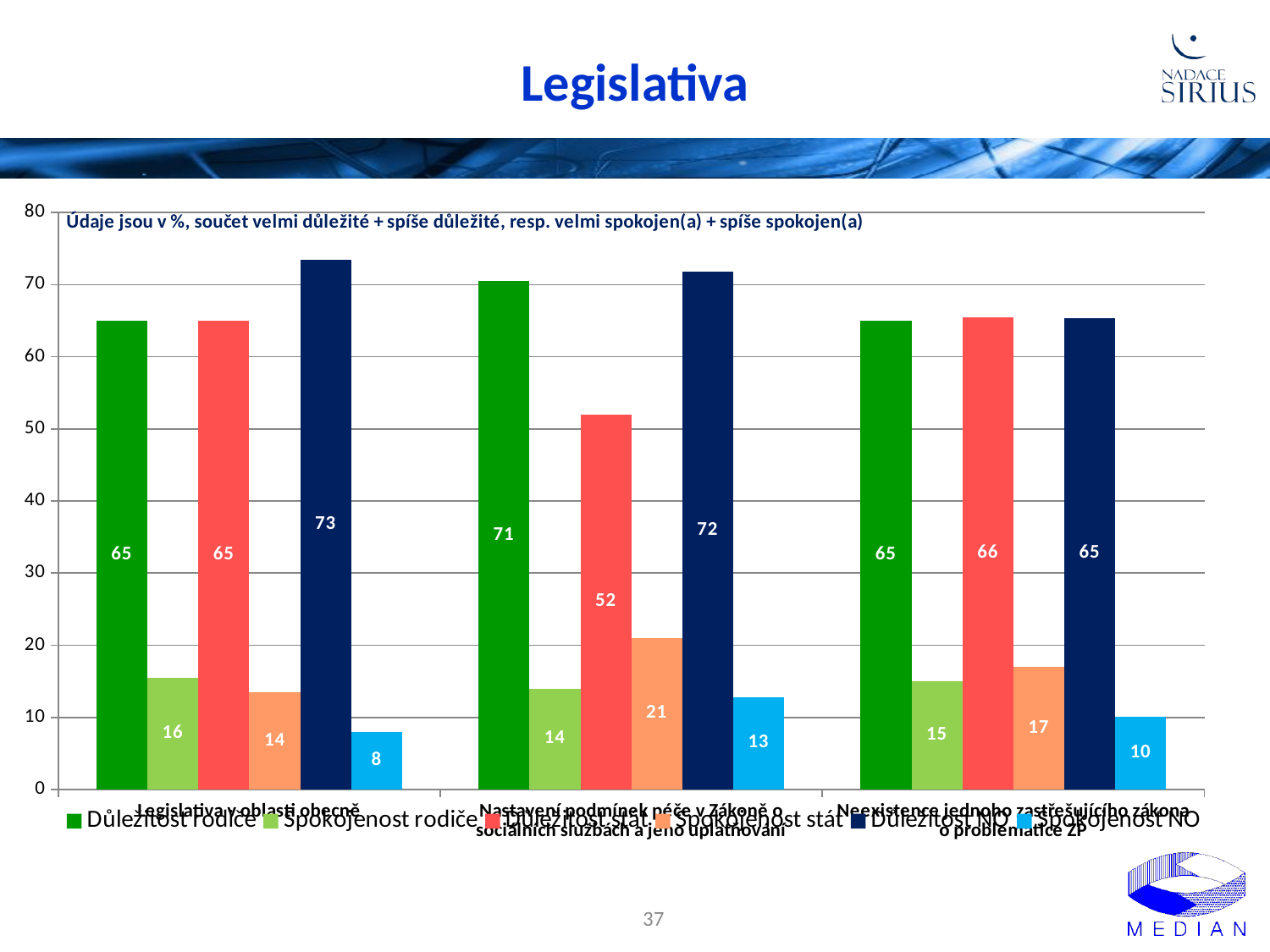
How many categories are shown on the x axis? 3 What is the title of the slide? Legislativa Which is larger in the first category, Legislativa v oblasti obecně: Spokojenost rodiče or Spokojenost stát? Spokojenost rodiče Is the value of Důležitost rodiče in the second category, Nastavení podmínek péče v Zákoně o sociálních službách a jeho uplatňování, greater or less than 60? greater What type of chart is shown on the slide? bar chart What is the value of Spokojenost NO for the category Neexistence jednoho zastřešujícího zákona o problematice ZP? 10 What is the difference between Důležitost stát and Spokojenost stát in the second category, Nastavení podmínek péče v Zákoně o sociálních službách a jeho uplatňování? 31 Which series has the highest value in the second category, Nastavení podmínek péče v Zákoně o sociálních službách a jeho uplatňování? Důležitost NO What is the value of Důležitost NO for the first category, Legislativa v oblasti obecně? 73 What is the value of Spokojenost stát for the category Nastavení podmínek péče v Zákoně o sociálních službách a jeho uplatňování? 21 How many series does the legend list? 6 Which series has the lowest value in the first category, Legislativa v oblasti obecně? Spokojenost NO